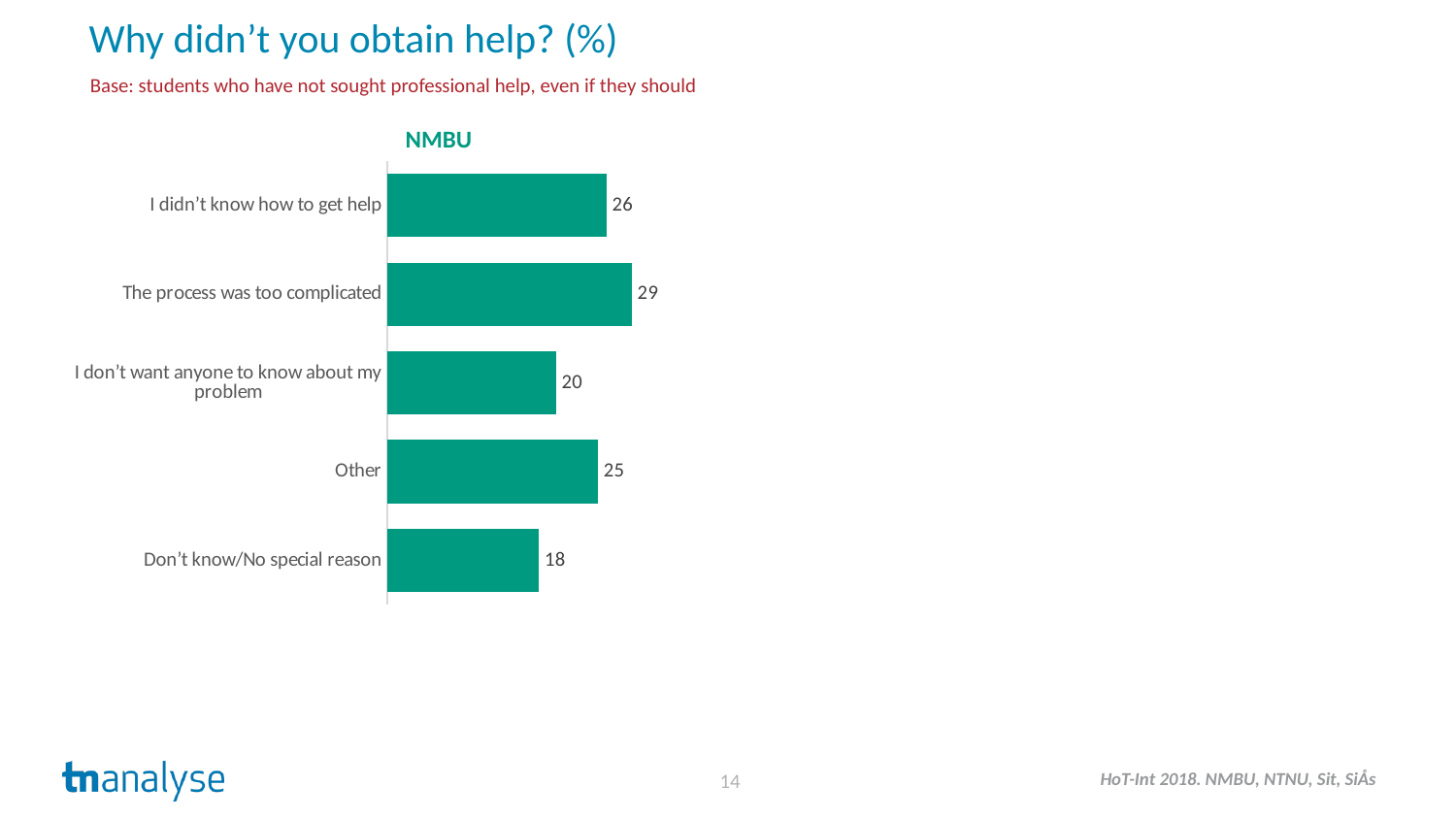
What is the difference between "I didn't know how to get help" and "Don't know/No special reason"? 8 Which category has the highest value? The process was too complicated Which category has the lowest value? Don't know/No special reason What kind of chart is shown on the slide? Bar chart What is the difference between "The process was too complicated" and "I don't want anyone to know about my problem"? 9 What is the title shown above the chart? NMBU What is the value for "Don't know/No special reason"? 18 Which is larger: "I didn't know how to get help" or "Other"? I didn't know how to get help What is the value for "The process was too complicated"? 29 What is the value for "Other"? 25 How many categories are shown in the chart? 5 What is the value for "I didn't know how to get help"? 26